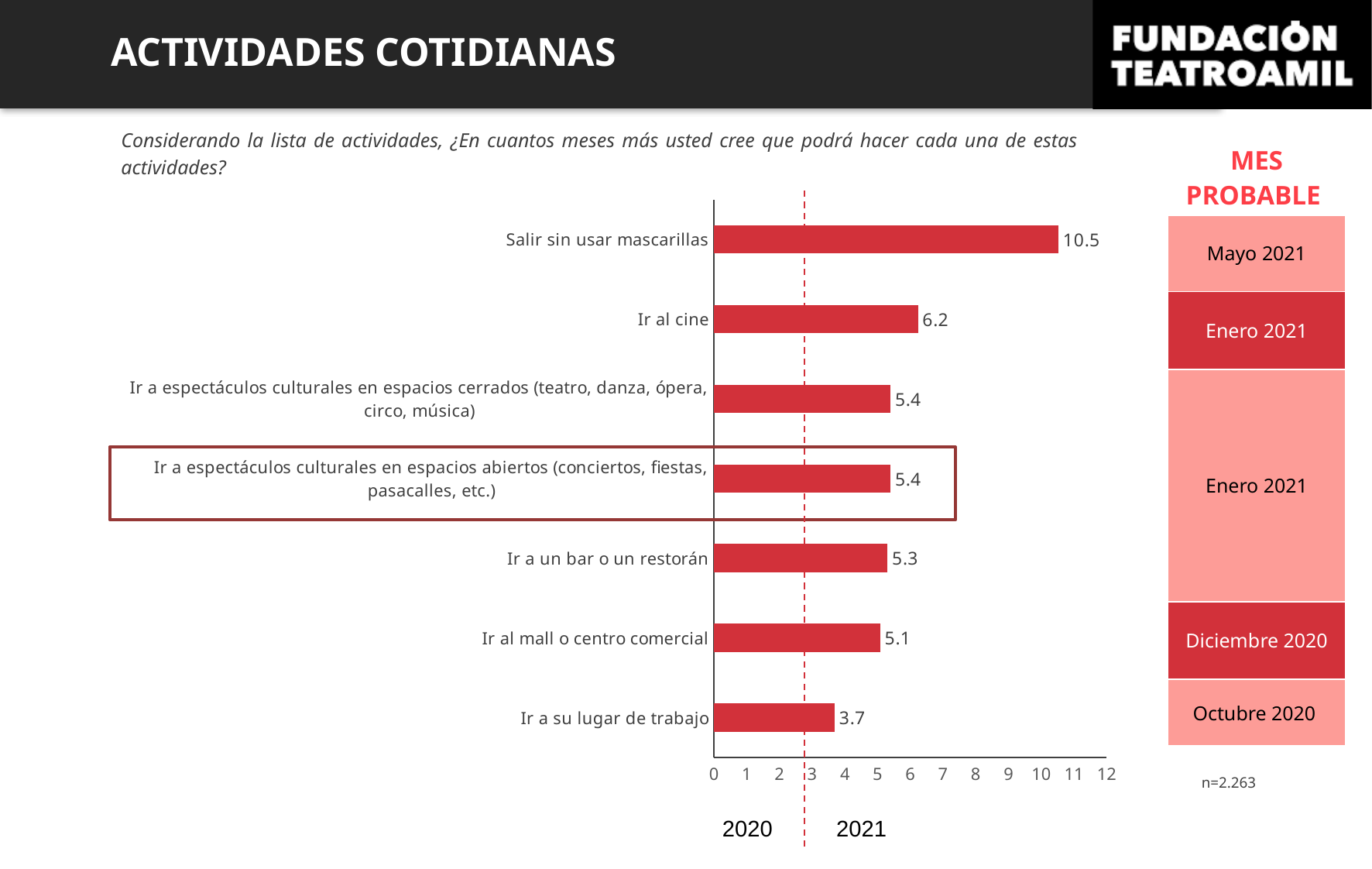
What is the value for "Salir sin usar mascarillas"? 10.5 What is the value for "Ir al mall o centro comercial"? 5.1 What kind of chart is shown on the slide? Bar chart What is the difference between the values for "Salir sin usar mascarillas" and "Ir al cine"? 4.3 What is the sample size (n) shown on the slide? n=2.263 What is the difference between the values for "Ir a un bar o un restorán" and "Ir a su lugar de trabajo"? 1.6 What is the value for "Ir a su lugar de trabajo"? 3.7 What is the value for "Ir al cine"? 6.2 How many activities are plotted in the chart? 7 Which is larger, the value for "Ir al cine" or the value for "Ir a un bar o un restorán"? Ir al cine Which activity has the lowest value? Ir a su lugar de trabajo Which activity has the highest value? Salir sin usar mascarillas